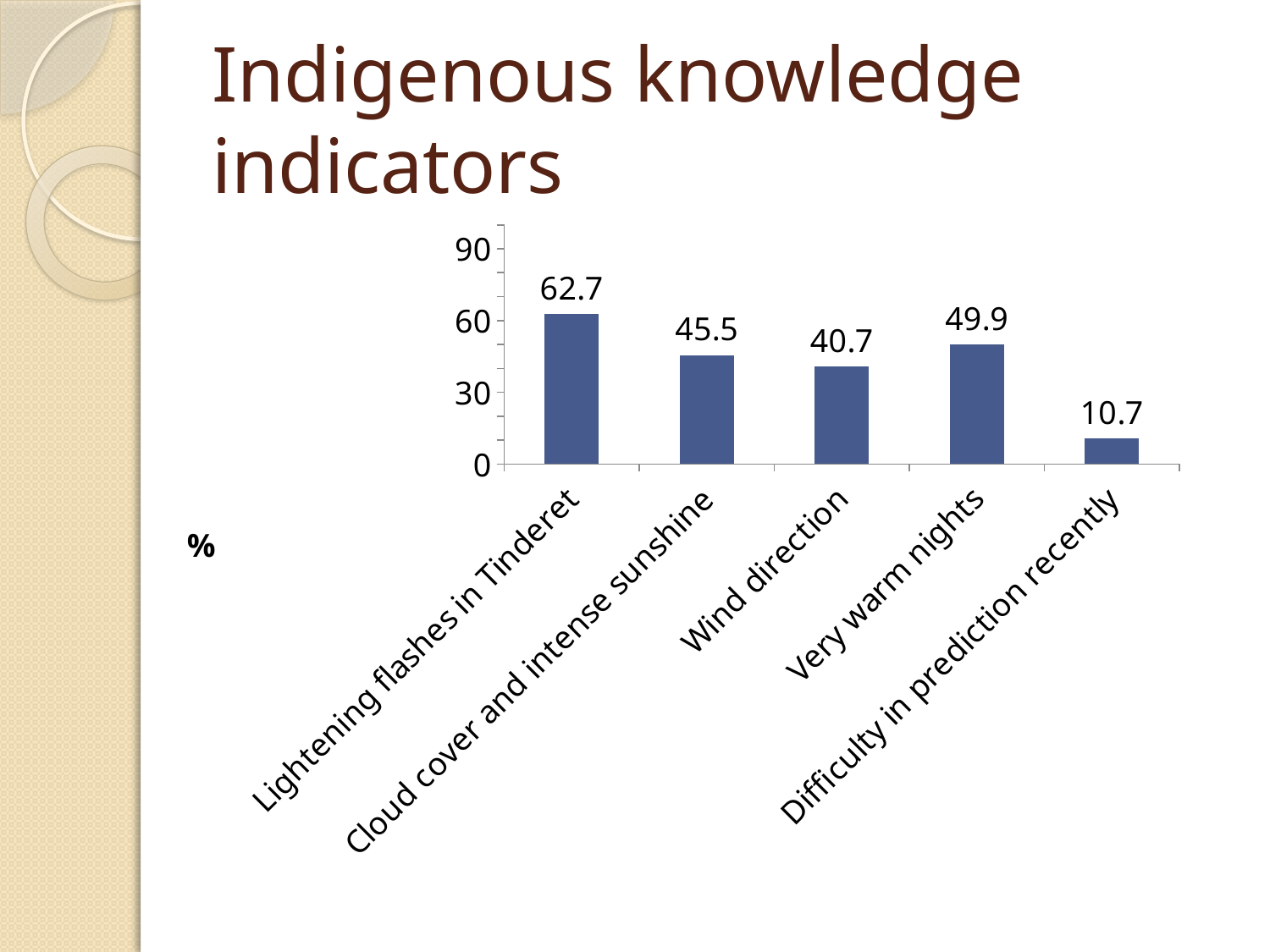
What is the difference between the values for Lightening flashes in Tinderet and Very warm nights? 12.8 What is the value for Cloud cover and intense sunshine? 45.5 What is the value for Difficulty in prediction recently? 10.7 What is the value for Very warm nights? 49.9 Is the value for Very warm nights greater or less than 60? less What is the value for Wind direction? 40.7 What kind of chart is shown on the slide? bar chart Which is larger, the value for Cloud cover and intense sunshine or the value for Wind direction? Cloud cover and intense sunshine Which category has the lowest value? Difficulty in prediction recently Which category has the highest value? Lightening flashes in Tinderet What is the value for Lightening flashes in Tinderet? 62.7 How many categories are shown in the chart? 5